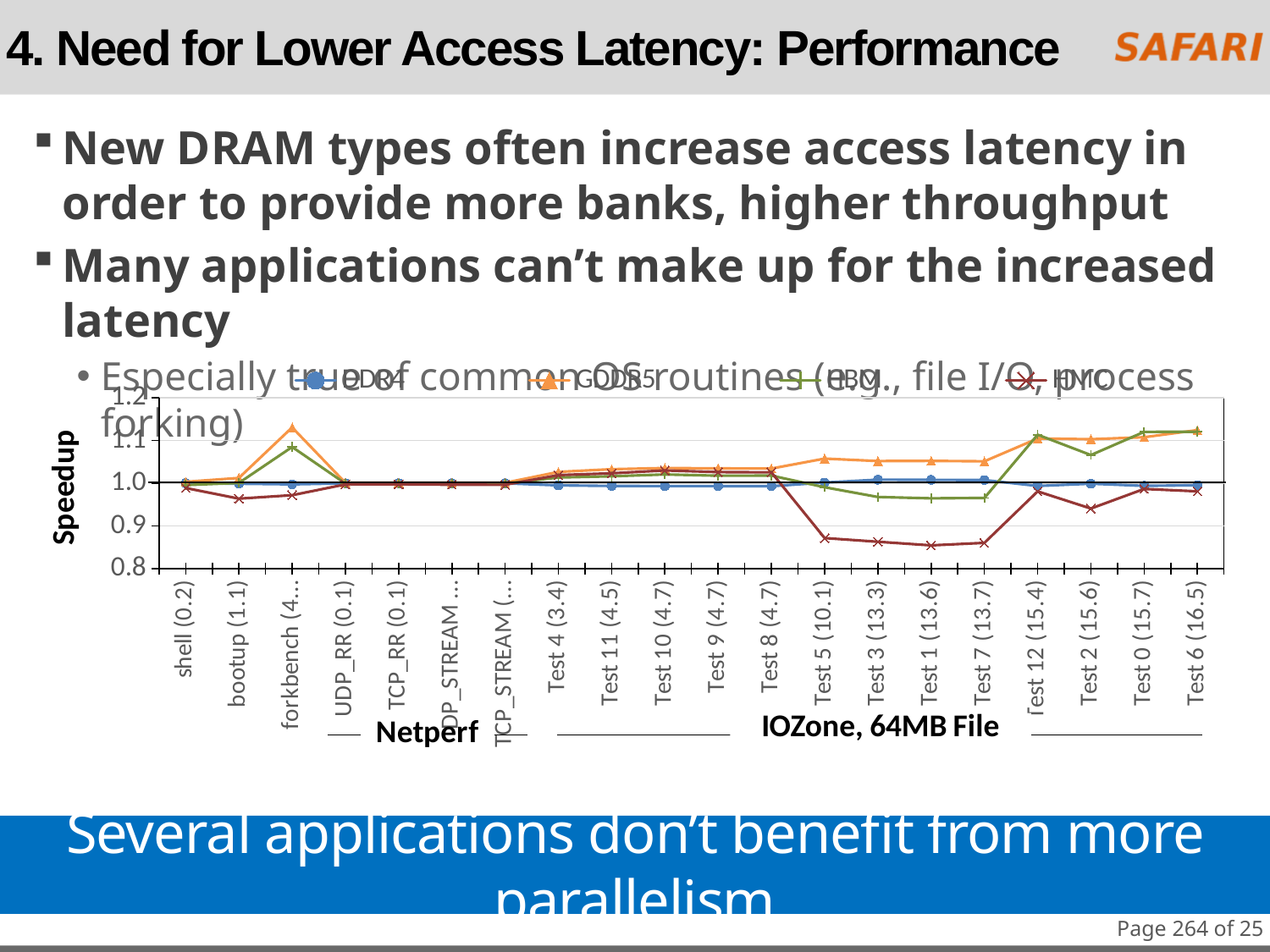
Is the HBM value for Test 6 (16.5) greater or less than 1.1? greater Which series has the highest speedup for forkbench? GDDR5 Which series has the lowest speedup for Test 1 (13.6)? HMC Which two benchmark groups are labelled beneath the x axis of the chart? Netperf and IOZone, 64MB File How many categories are plotted along the x axis of the chart? 20 How many series does the chart's legend list? 4 What is the title of the y axis of the chart? Speedup What kind of chart is shown on the slide? line chart Is the GDDR5 value for forkbench greater or less than 1.1? greater